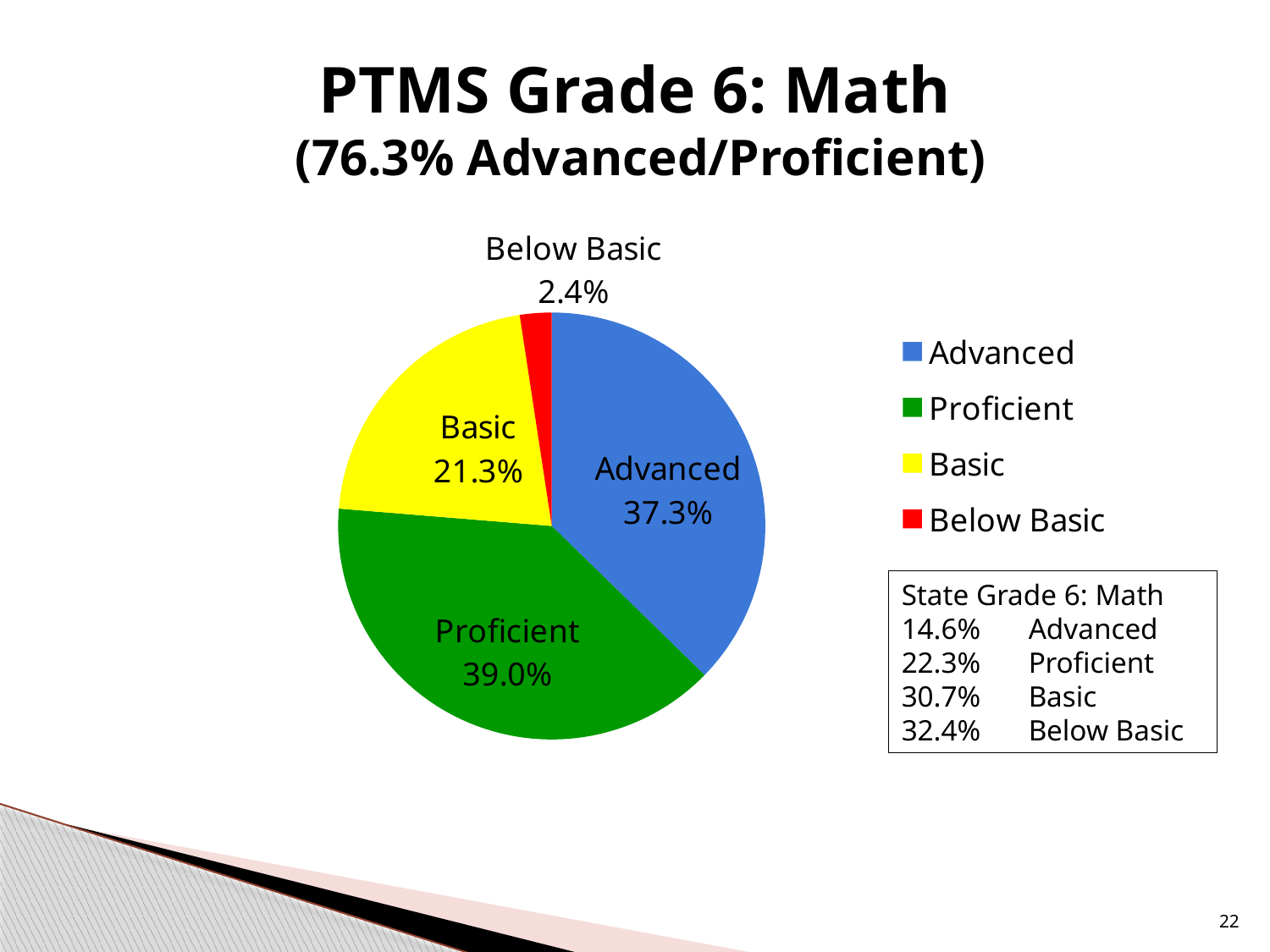
What percentage of the pie is labelled Proficient? 39.0% What is the difference between the Advanced and Basic percentages? 16.0% What kind of chart is shown on the slide? Pie chart What percentage of the pie is labelled Advanced? 37.3% Which is larger, the Basic slice or the Below Basic slice? Basic What is the combined share of the Advanced and Proficient slices? 76.3% What percentage of the pie is labelled Below Basic? 2.4% What colour is the Proficient slice in the pie chart? Green Which category has the smallest slice of the pie? Below Basic How many slices does the pie chart have? 4 What percentage of the pie is labelled Basic? 21.3% Which category has the largest slice of the pie? Proficient